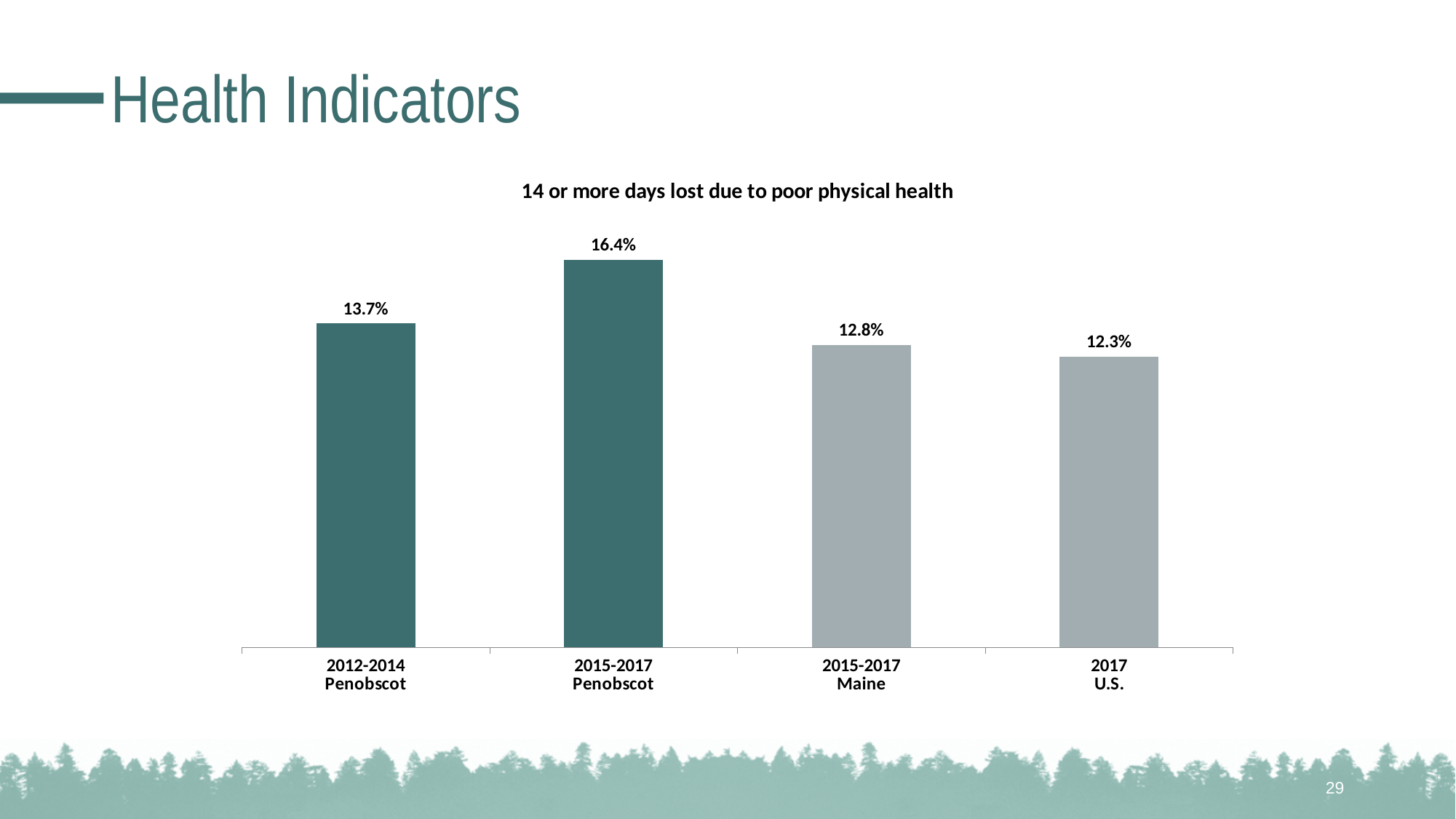
What is the value for 2017 U.S.? 12.3% What is the value for 2015-2017 Maine? 12.8% What is the title of the chart? 14 or more days lost due to poor physical health How many categories are shown in the chart? 4 What is the value for 2015-2017 Penobscot? 16.4% What kind of chart is shown on the slide? Bar chart Which category has the highest value? 2015-2017 Penobscot What is the difference between the 2015-2017 Maine value and the 2017 U.S. value? 0.5% Which category has the lowest value? 2017 U.S. What is the difference between the 2015-2017 Penobscot value and the 2012-2014 Penobscot value? 2.7% What is the value for 2012-2014 Penobscot? 13.7% Which is larger, the value for 2015-2017 Penobscot or the value for 2015-2017 Maine? 2015-2017 Penobscot